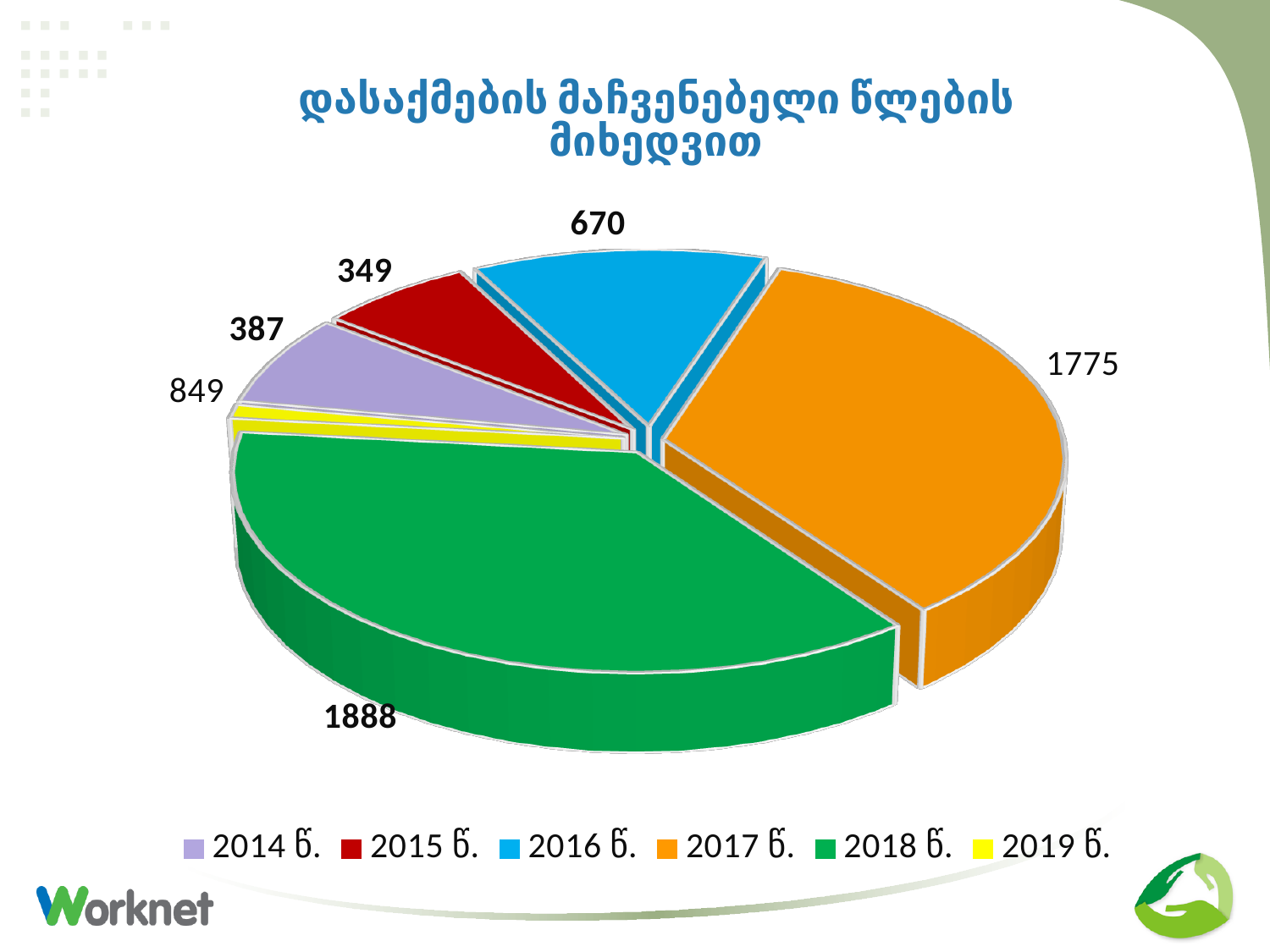
How many entries does the legend list? 6 Which year has the largest slice? 2018 წ. What is the difference between the values for 2018 წ. and 2017 წ.? 113 What is the value for 2014 წ.? 387 What colour is the slice for 2018 წ.? green What is the value for 2016 წ.? 670 What is the value for 2015 წ.? 349 What is the value for 2018 წ.? 1888 What is the difference between the values for 2014 წ. and 2015 წ.? 38 What kind of chart is shown on the slide? pie chart What is the value for 2017 წ.? 1775 Which is larger, the value for 2016 წ. or the value for 2015 წ.? 2016 წ.